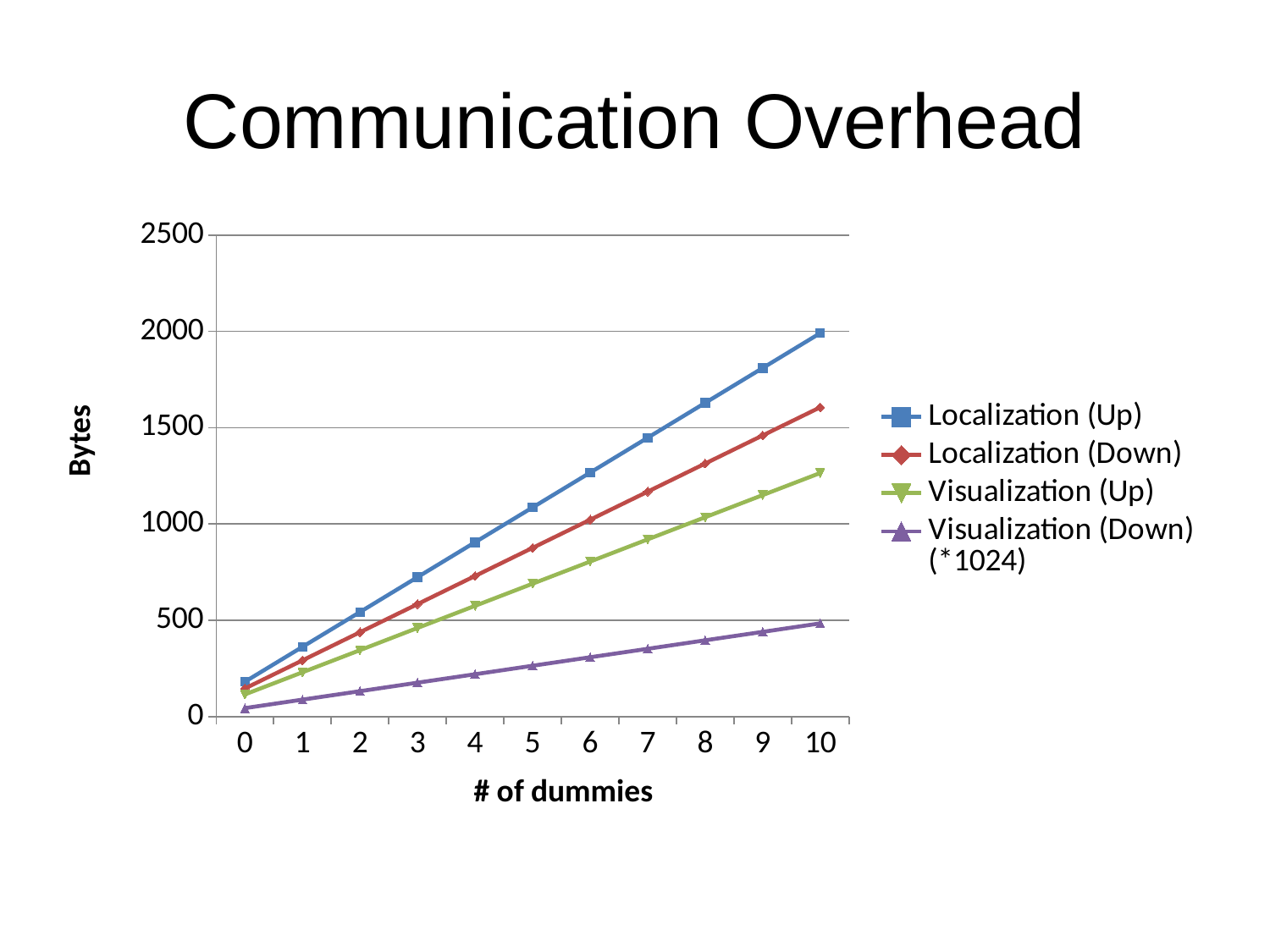
What kind of chart is shown on the slide? line chart Is the value for Localization (Up) at 10 dummies greater or less than 1500? greater Which series has the lowest value at 10 dummies? Visualization (Down) (*1024) Which series has the highest value at 10 dummies? Localization (Up) What is the label of the vertical axis? Bytes How many points along the x axis (# of dummies) are plotted for each series? 11 At 10 dummies, which is larger: Localization (Down) or Visualization (Up)? Localization (Down) Is the value for Visualization (Up) at 10 dummies greater or less than 1000? greater Is the value for Visualization (Down) (*1024) at 5 dummies greater or less than 500? less Do the values for Localization (Up) rise or fall as the number of dummies increases? rise How many series does the legend list? 4 What is the title of the chart? Communication Overhead